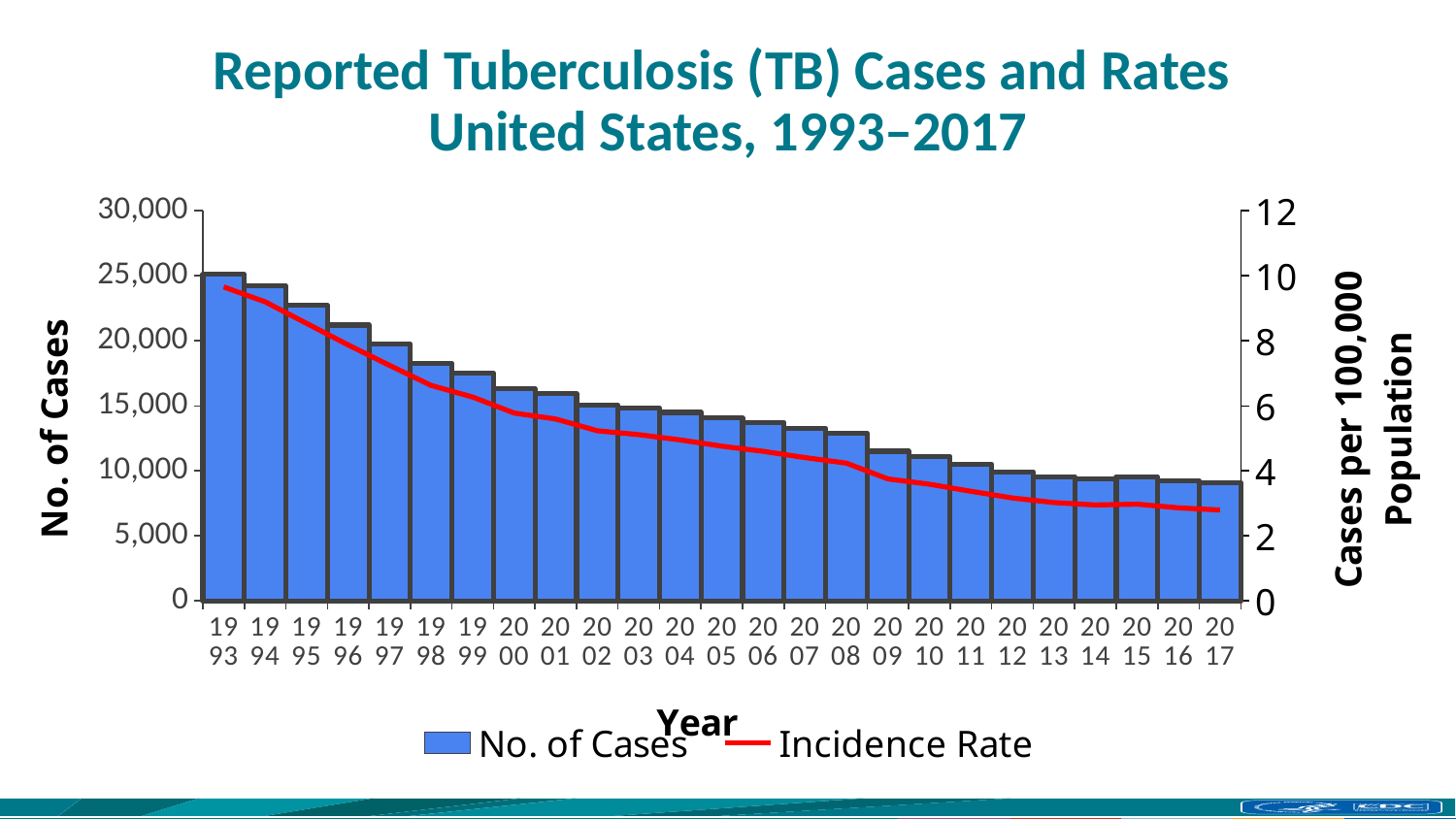
Is the incidence rate in 1993 greater or less than 8 cases per 100,000 population? greater How many years are plotted along the x axis? 25 Which year has the highest number of TB cases? 1993 Is the incidence rate in 2017 greater or less than 4 cases per 100,000 population? less What kind of chart is shown on the slide? A bar chart with a line overlay Is the number of cases in 1993 greater or less than 20,000? greater How many series does the legend list? 2 Do the number of TB cases rise or fall from 1993 to 2017? Fall Which year had more TB cases, 1995 or 2005? 1995 What are the two entries in the chart legend? No. of Cases and Incidence Rate